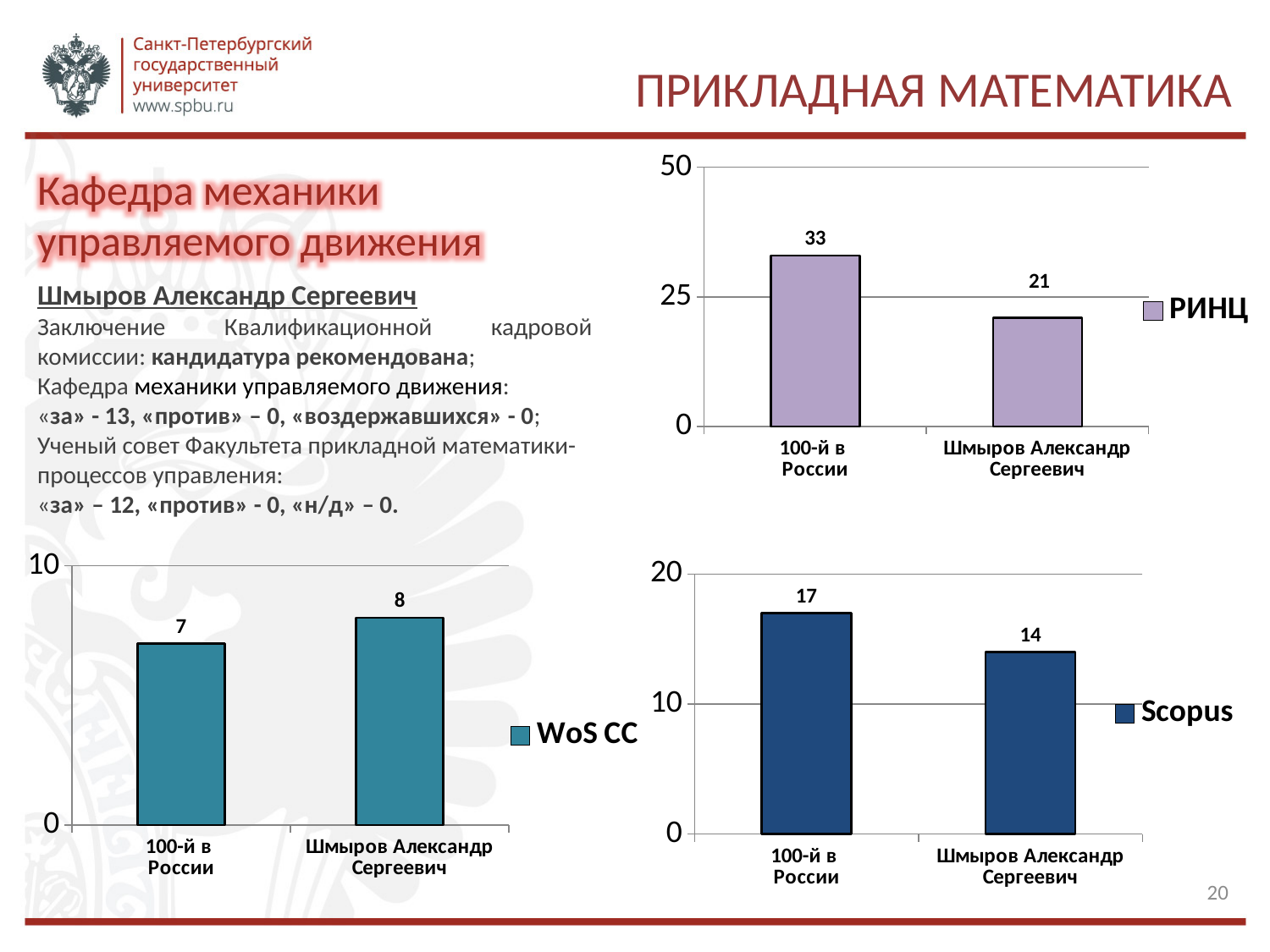
In the РИНЦ chart (top right), what is the difference between the value for 100-й в России and the value for Шмыров Александр Сергеевич? 12 In the Scopus chart (bottom right), what is the value for Шмыров Александр Сергеевич? 14 In the РИНЦ chart (top right), what is the value for 100-й в России? 33 In the WoS CC chart (bottom left), what is the difference between the two bars? 1 In the WoS CC chart (bottom left), which category has the higher value? Шмыров Александр Сергеевич What kind of chart is the WoS CC chart (bottom left)? bar chart How many categories are shown in the РИНЦ chart (top right)? 2 In the Scopus chart (bottom right), what is the value for 100-й в России? 17 In the Scopus chart (bottom right), which category has the lower value? Шмыров Александр Сергеевич In the Scopus chart (bottom right), is the value for 100-й в России greater or less than 10? greater In the WoS CC chart (bottom left), what is the value for Шмыров Александр Сергеевич? 8 In the РИНЦ chart (top right), what is the value for Шмыров Александр Сергеевич? 21